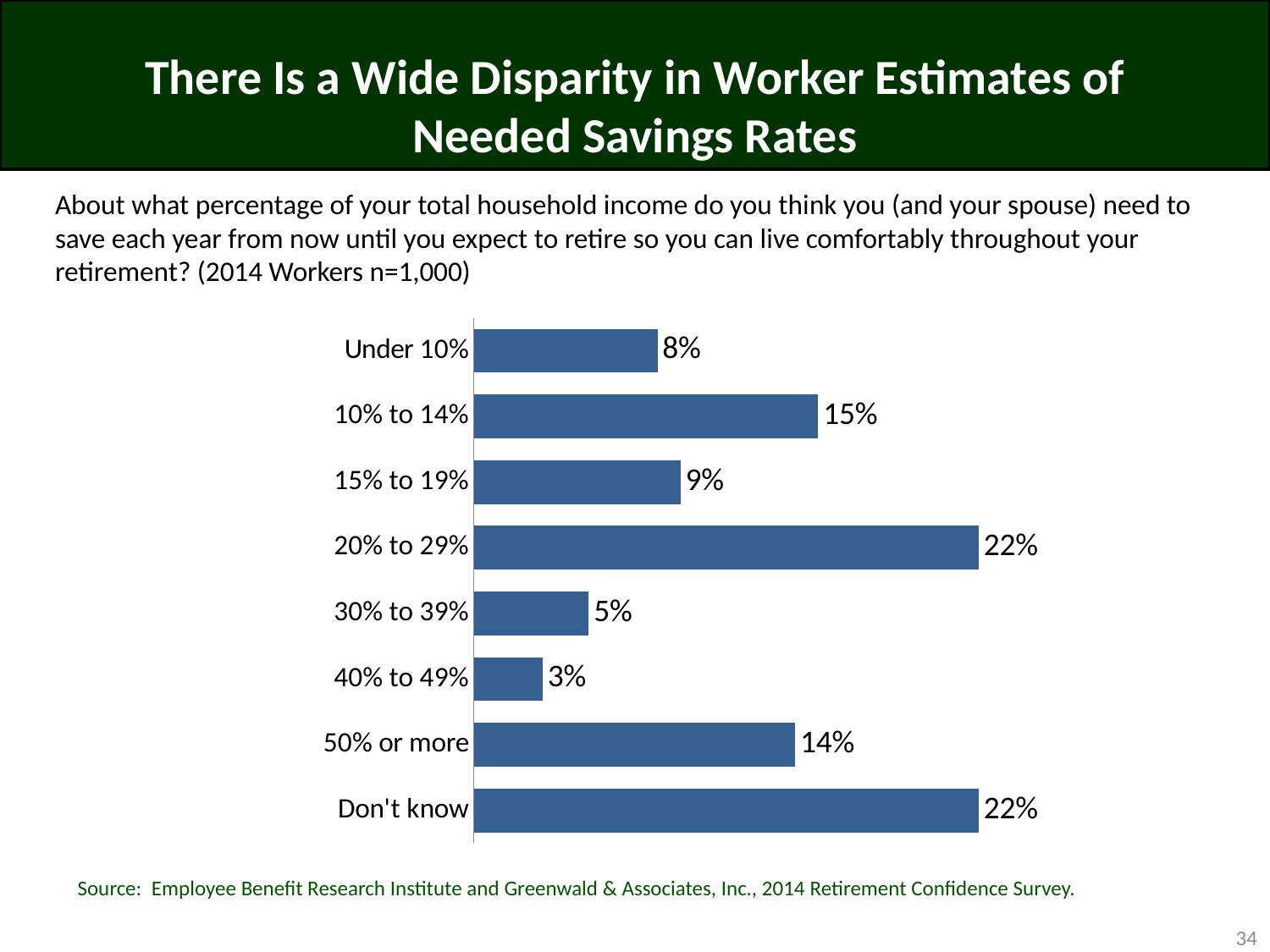
Which category has the lowest value? 40% to 49% What is the value for the 'Don't know' category? 22% What is the value for the '50% or more' category? 14% Which is larger, the value for 'Under 10%' or the value for '15% to 19%'? 15% to 19% Which is larger, the value for '10% to 14%' or the value for '50% or more'? 10% to 14% What is the value for the '40% to 49%' category? 3% What kind of chart is shown on the slide? Bar chart What percentage of workers said they need to save 20% to 29% of household income? 22% What is the difference between the values for '10% to 14%' and '15% to 19%'? 6% What is the value for the 'Under 10%' category? 8% What is the difference between the values for '20% to 29%' and '30% to 39%'? 17% How many categories are shown in the chart? 8